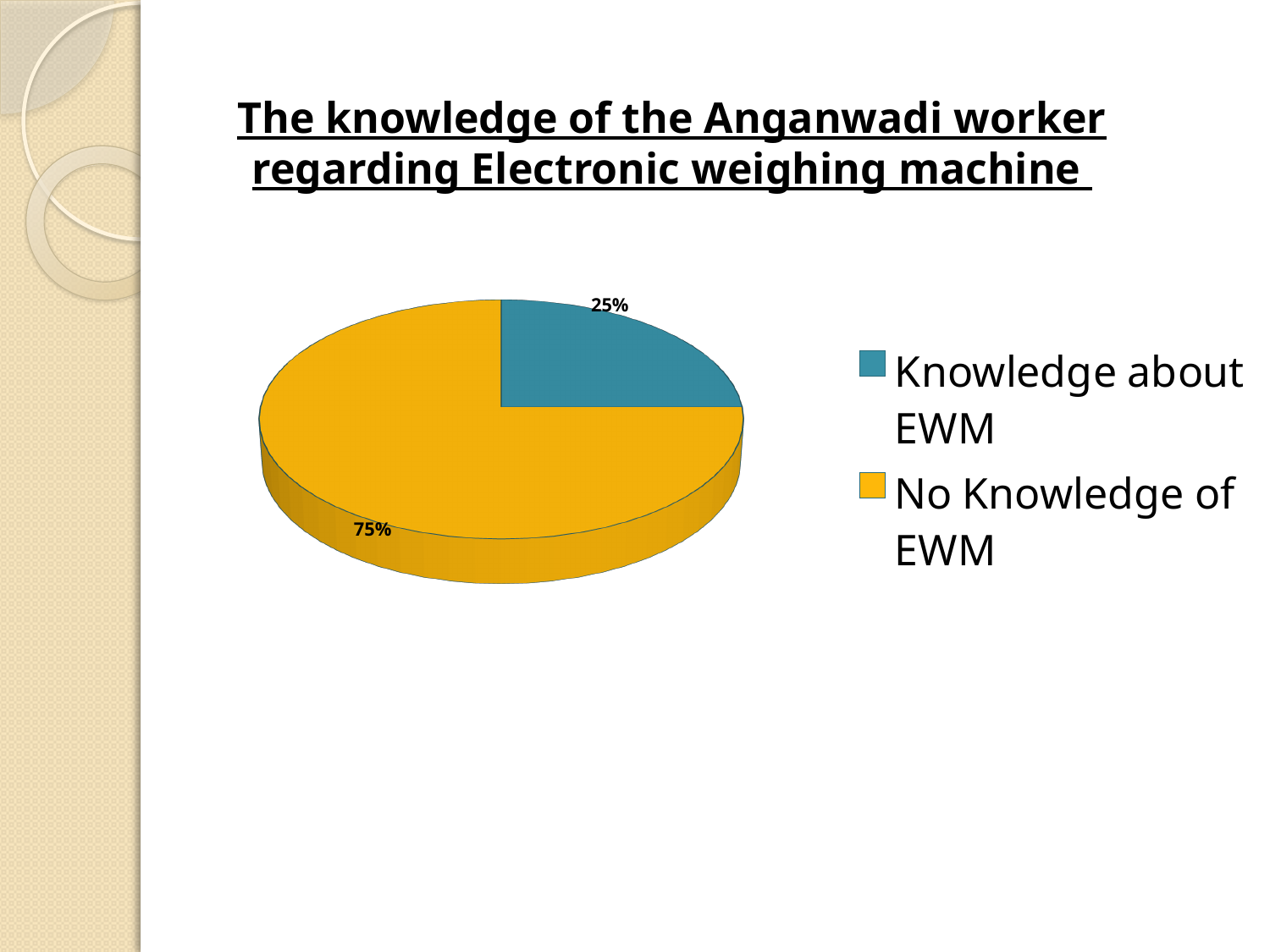
What kind of chart is shown on the slide? Pie chart What is the difference in percentage points between 'No Knowledge of EWM' and 'Knowledge about EWM'? 50 How many categories are shown in the pie chart? 2 What is the title of the chart on the slide? The knowledge of the Anganwadi worker regarding Electronic weighing machine What share of the pie does the 'Knowledge about EWM' slice represent? 25% What percentage of Anganwadi workers have no knowledge of EWM? 75% Which category has the smallest share of the pie? Knowledge about EWM Which is larger: the share for 'Knowledge about EWM' or the share for 'No Knowledge of EWM'? No Knowledge of EWM What colour is the 'No Knowledge of EWM' slice? Yellow How many entries does the legend list? 2 What percentage of Anganwadi workers have knowledge about EWM? 25% Which category has the largest share of the pie? No Knowledge of EWM